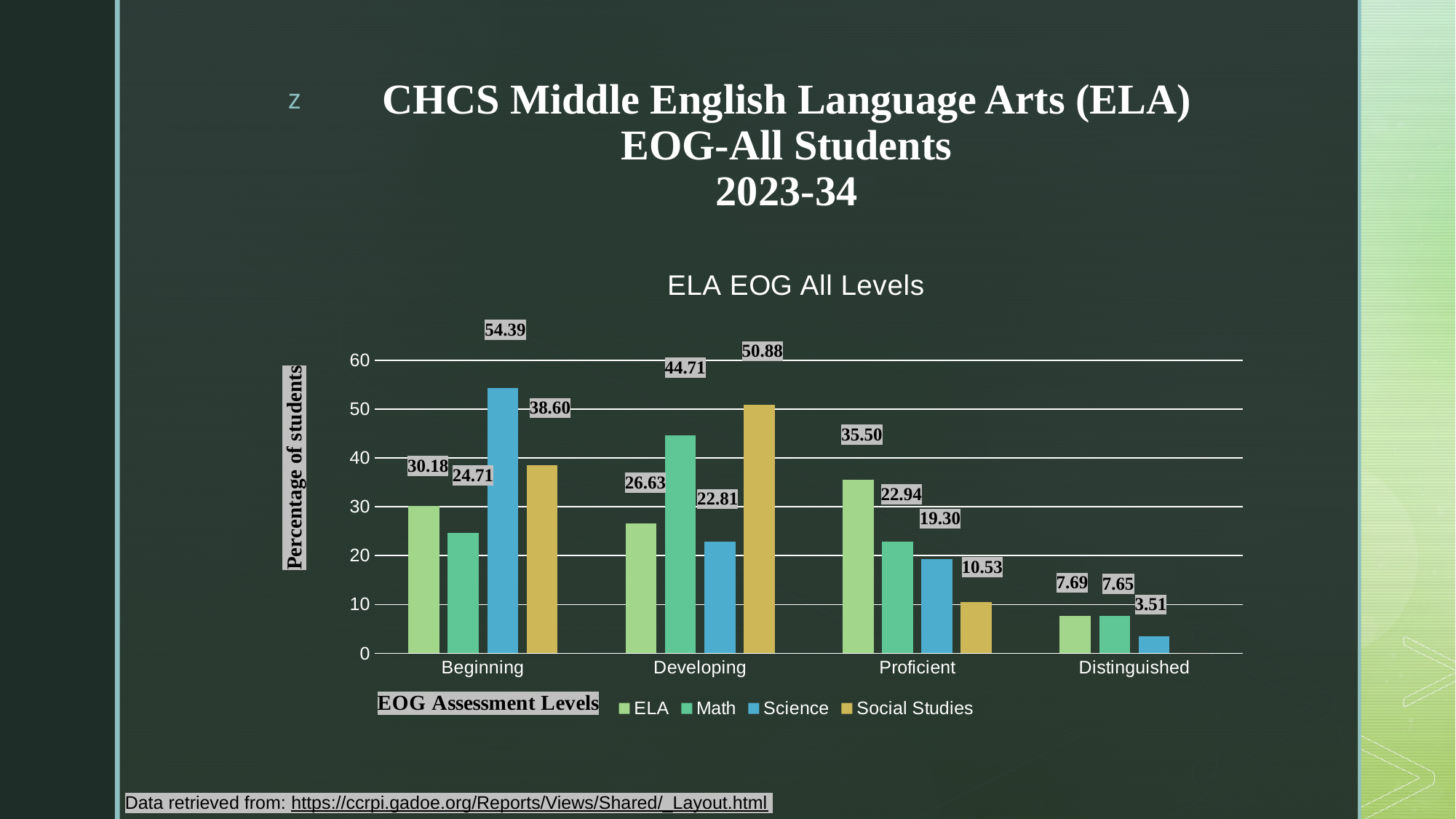
What is the difference between the Math value at Developing and the Math value at Proficient? 21.77 What is the difference between the Science and Social Studies values at the Beginning level? 15.79 At the Developing level, which is larger: the Math value or the ELA value? Math At which assessment level is the Science value lowest? Distinguished What is the value for Science at the Beginning level? 54.39 What is the value for Social Studies at the Developing level? 50.88 Is the value for ELA at the Proficient level greater or less than 30? greater What kind of chart is shown on the slide? bar chart How many series does the legend list? 4 How many assessment levels are shown on the x axis? 4 Do the Science values rise or fall from Beginning to Distinguished? fall Which subject has the highest value at the Proficient level? ELA